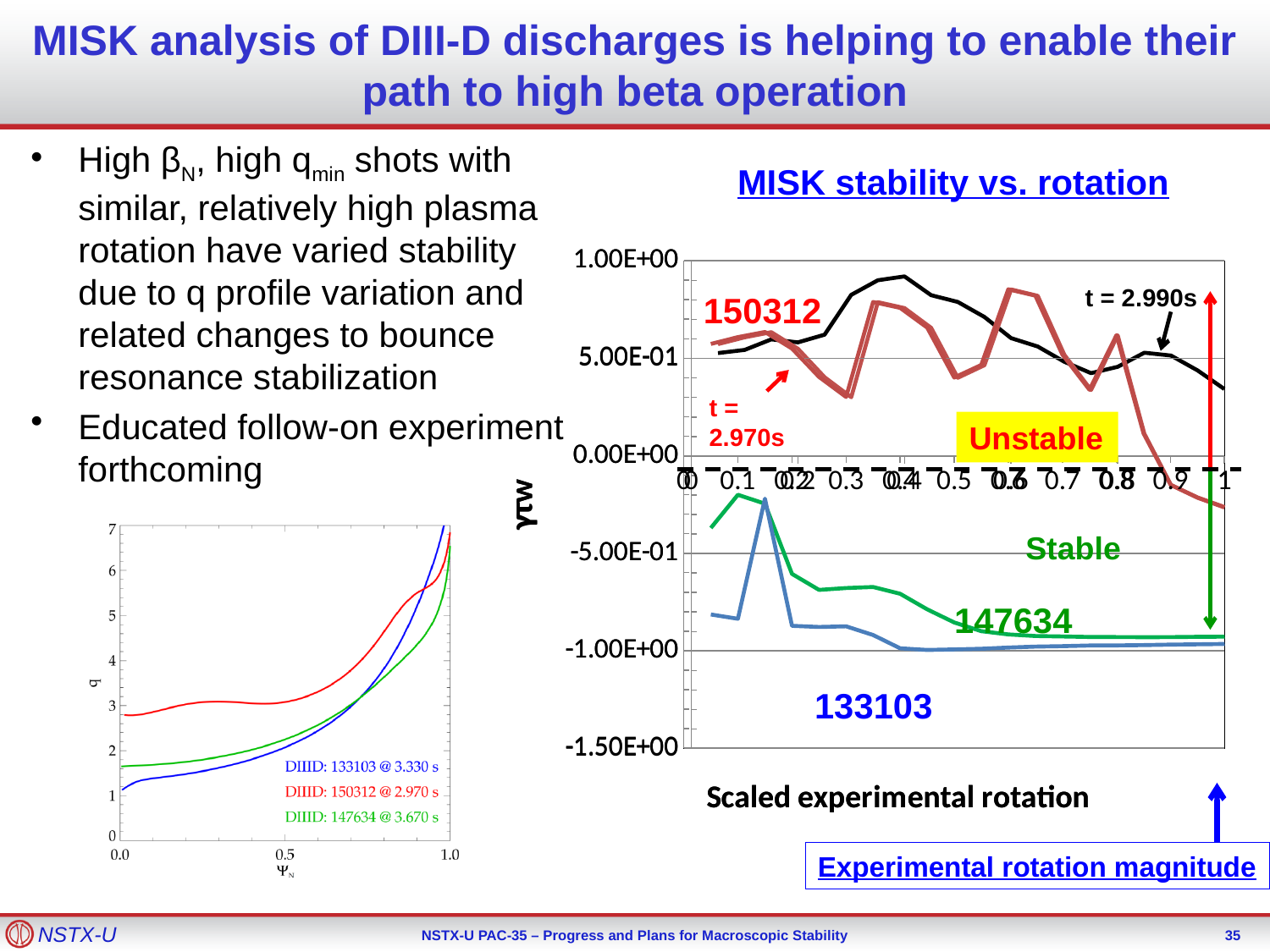
In the 'MISK stability vs. rotation' chart, which discharge has the lowest value at a scaled rotation of 0.1? 133103 In the q profile chart at the bottom left, which discharge has the highest q at Ψ_N = 0.0? 150312 In the 'MISK stability vs. rotation' chart, which region label is placed above the zero line? Unstable What is the x-axis title of the 'MISK stability vs. rotation' chart? Scaled experimental rotation In the q profile chart at the bottom left, how many discharges are listed in the legend? 3 In the 'MISK stability vs. rotation' chart, is the value for discharge 133103 at a scaled rotation of 0.5 greater or less than -5.00E-01? less In the 'MISK stability vs. rotation' chart, how many discharge numbers are labeled on the plot? 3 What kind of chart is the 'MISK stability vs. rotation' chart? line chart In the q profile chart at the bottom left, at what time is discharge 147634 shown? 3.670 s In the 'MISK stability vs. rotation' chart, is the value for discharge 150312 at t = 2.970s at a scaled rotation of 0.6 greater or less than 5.00E-01? greater In the 'MISK stability vs. rotation' chart, at a scaled rotation of 0.6, which is higher: discharge 150312 or discharge 147634? 150312 In the q profile chart at the bottom left, does q rise or fall as Ψ_N increases from 0.0 to 1.0? rise